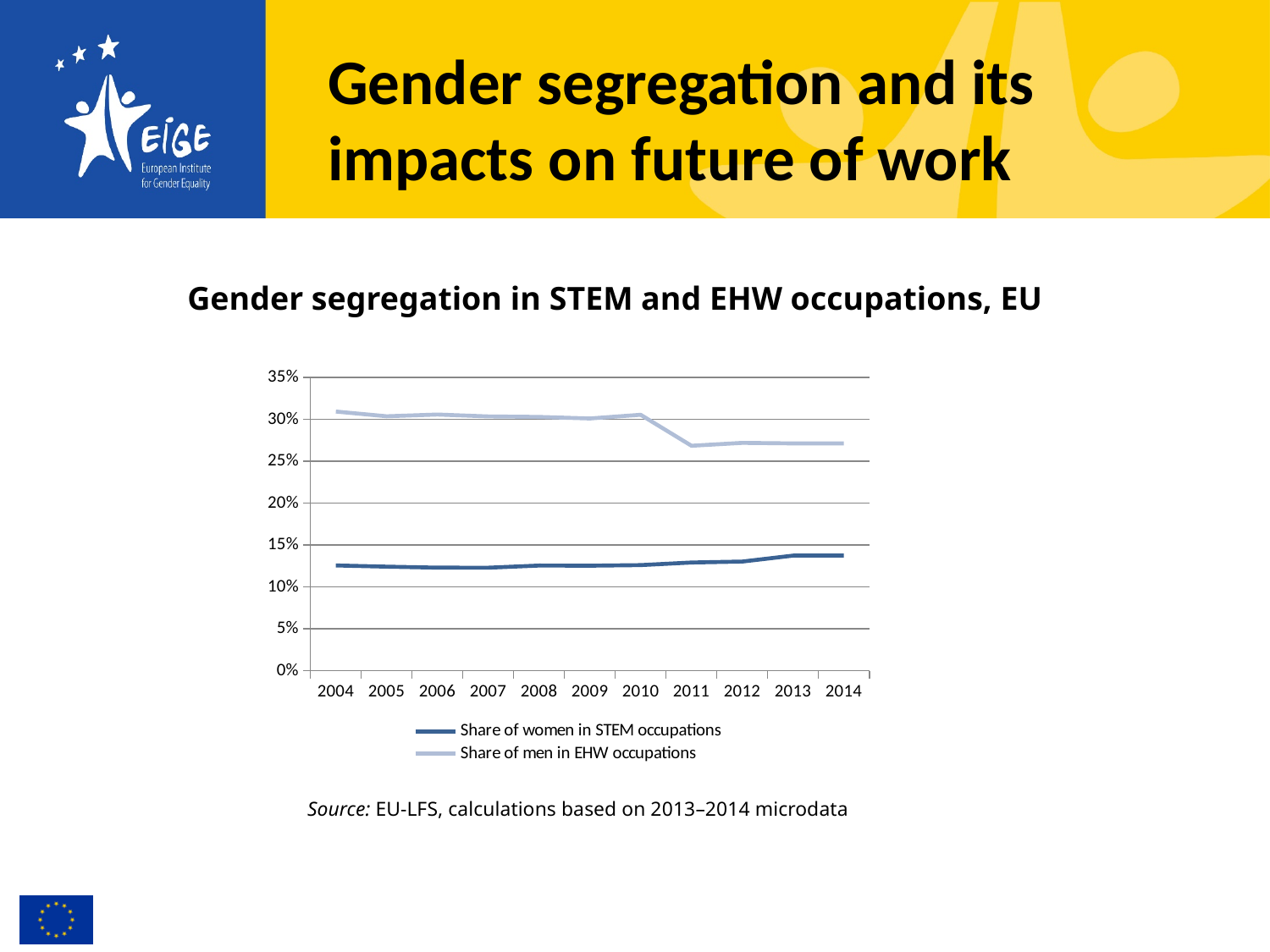
Does the share of men in EHW occupations rise or fall between 2010 and 2011? Fall Does the share of women in STEM occupations rise or fall from 2004 to 2014? Rise Is the share of women in STEM occupations in 2004 greater or less than 15%? less How many series does the legend list? 2 Is the share of men in EHW occupations in 2004 greater or less than 30%? greater What kind of chart is shown on the slide? Line chart How many years are shown on the x axis? 11 In 2010, which is higher: the share of women in STEM occupations or the share of men in EHW occupations? Share of men in EHW occupations What is the title of the chart? Gender segregation in STEM and EHW occupations, EU Is the share of men in EHW occupations in 2012 greater or less than 25%? greater